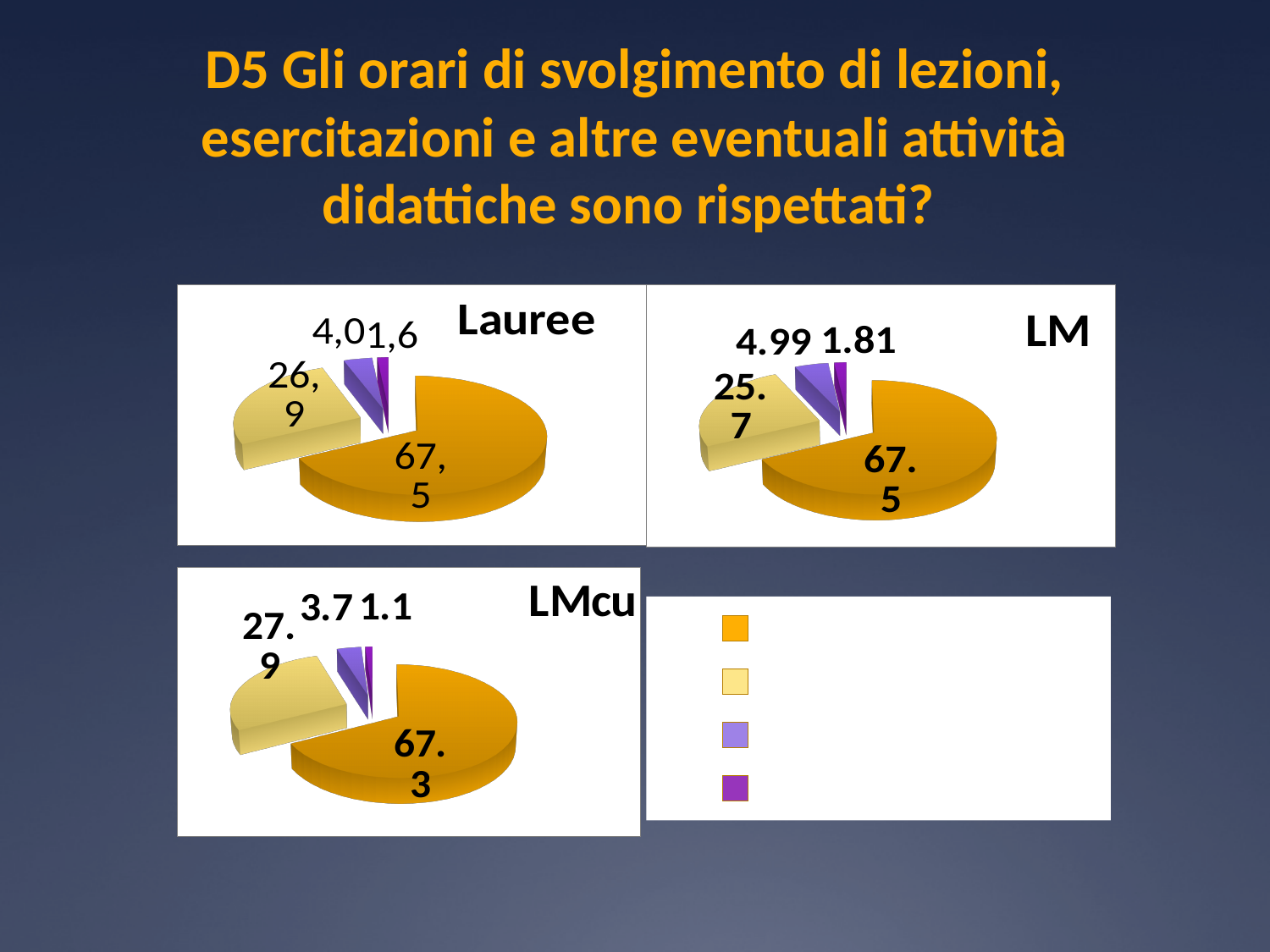
Which chart has the larger light yellow slice, 'Lauree' (26,9) or 'LMcu' (27.9)? LMcu How many pie charts are shown on the slide? 3 How many slices does the 'LM' pie chart have? 4 In the 'LM' chart, what is the value of the smallest slice? 1.81 How many colour entries does the legend box on the slide show? 4 In the 'Lauree' chart, what is the value of the largest slice? 67,5 What kind of chart is the 'Lauree' chart? pie chart In the 'LMcu' chart, what is the value of the light yellow slice? 27.9 In the 'LM' chart, what is the difference between the largest slice (67.5) and the light yellow slice (25.7)? 41.8 In the 'LMcu' chart, what is the value of the largest slice? 67.3 In the 'Lauree' chart, what is the value of the dark purple slice? 1,6 In the 'LM' chart, what is the value of the light purple slice? 4.99